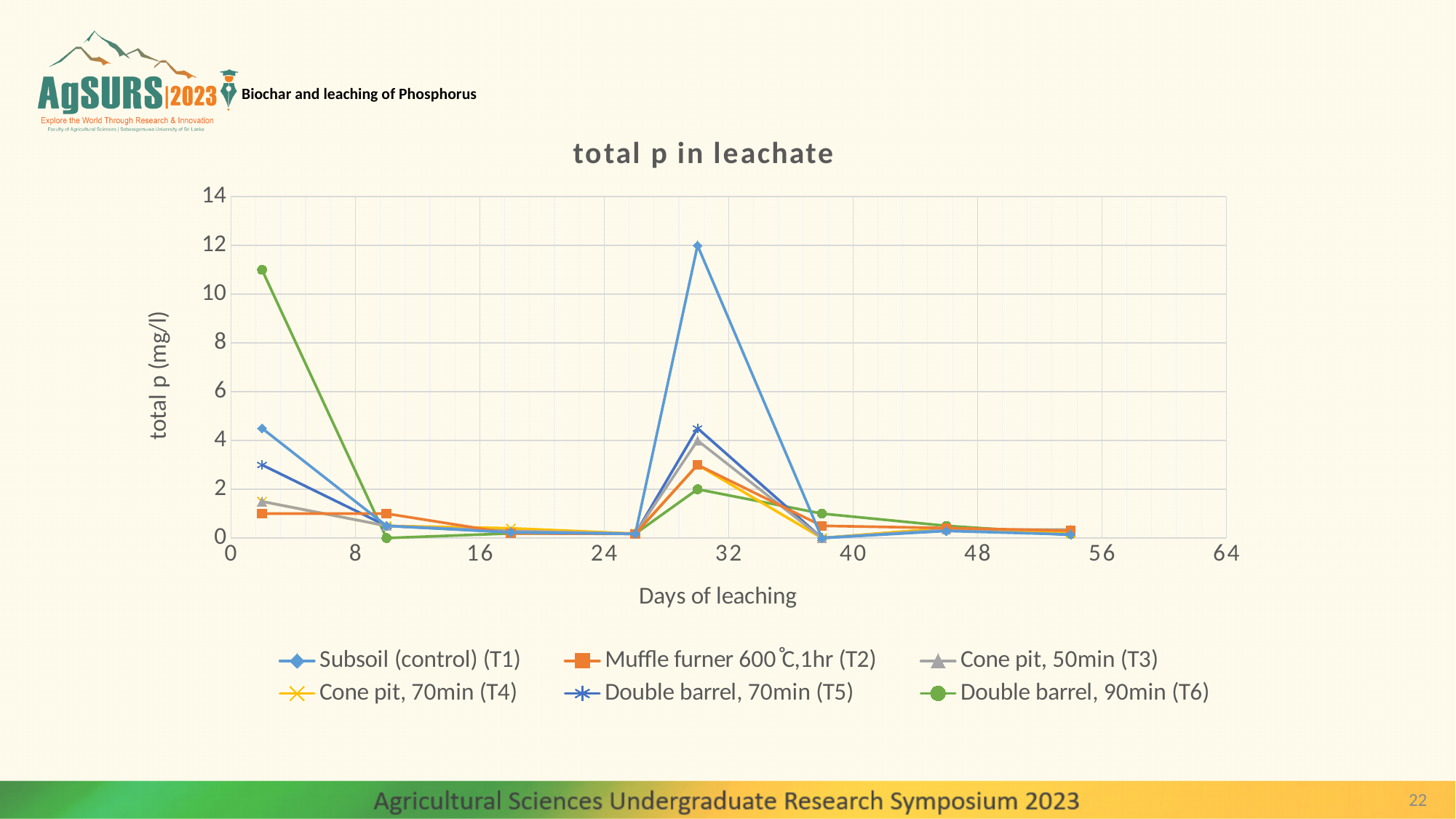
Is the first value of Double barrel, 70min (T5) greater or less than 2? greater Is the value of Double barrel, 90min (T6) at around day 30 greater or less than 4? less Does the Double barrel, 90min (T6) line rise or fall between its first point and day 10? fall Which series reaches the highest value anywhere on the chart? Subsoil (control) (T1) How many series does the legend list? 6 What is the label of the x axis? Days of leaching What kind of chart is shown on the slide? line chart What is the title of the chart? total p in leachate At around day 30, which is larger: Subsoil (control) (T1) or Double barrel, 90min (T6)? Subsoil (control) (T1) At the first sampling point, which is larger: Double barrel, 90min (T6) or Subsoil (control) (T1)? Double barrel, 90min (T6) Is the peak value of Subsoil (control) (T1) at around day 30 greater or less than 10? greater